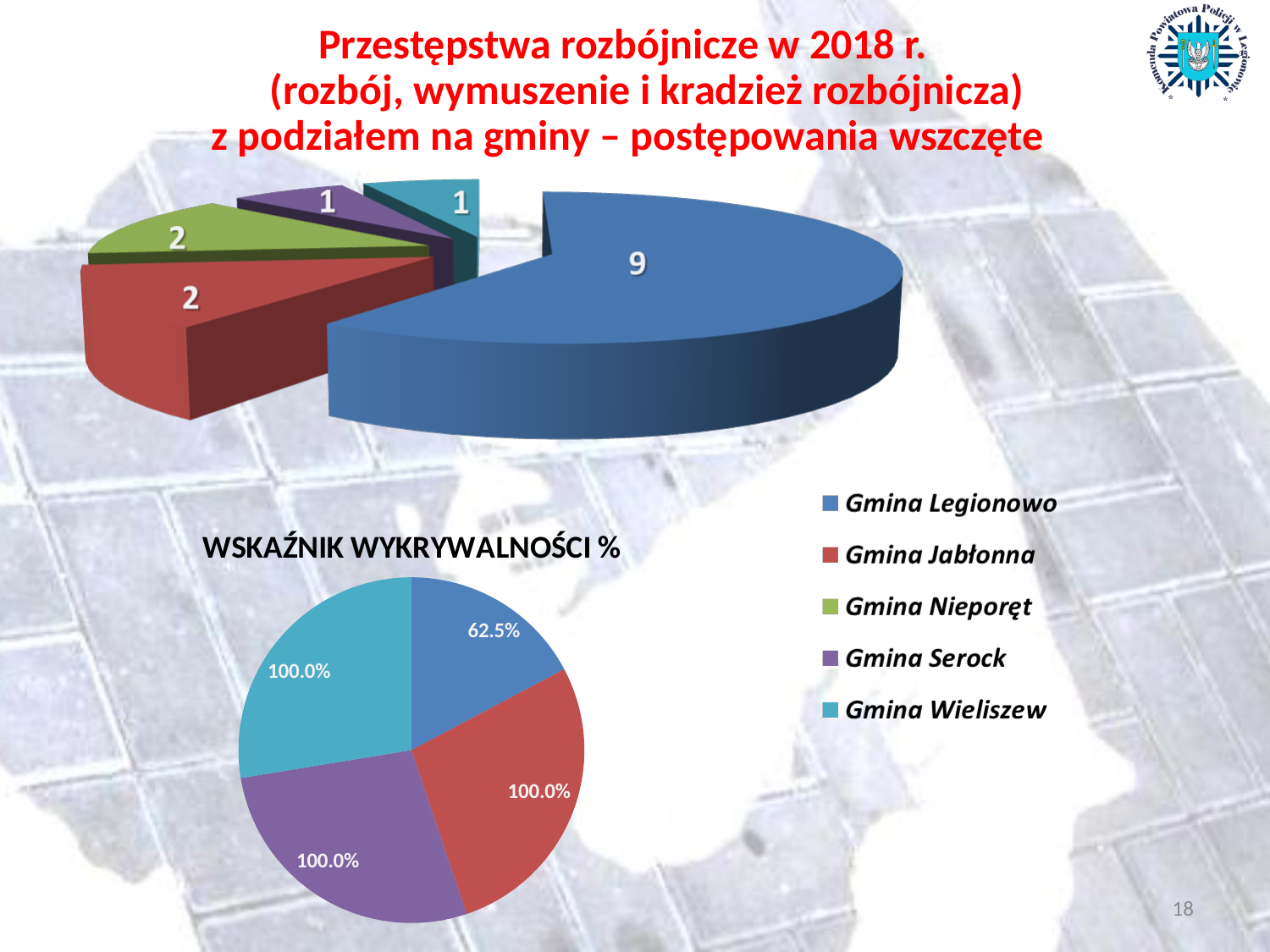
In the top pie chart, what is the difference between the values for Gmina Legionowo and Gmina Nieporęt? 7 In the top pie chart, which is larger: the value for Gmina Jabłonna or the value for Gmina Wieliszew? Gmina Jabłonna How many entries does the legend list? 5 In the top pie chart, what share of the total does Gmina Legionowo represent? 60% In the top pie chart, what is the value for Gmina Jabłonna? 2 In the top pie chart, what is the value for Gmina Serock? 1 In the top pie chart, which gmina has the highest value? Gmina Legionowo In the top pie chart, what is the value for Gmina Legionowo? 9 What type of chart is the bottom chart titled WSKAŹNIK WYKRYWALNOŚCI %? Pie chart In the top pie chart, what is the total of all the slice values? 15 In the bottom chart titled WSKAŹNIK WYKRYWALNOŚCI %, how many slices are shown? 4 In the bottom chart titled WSKAŹNIK WYKRYWALNOŚCI %, what is the value for Gmina Legionowo? 62.5%